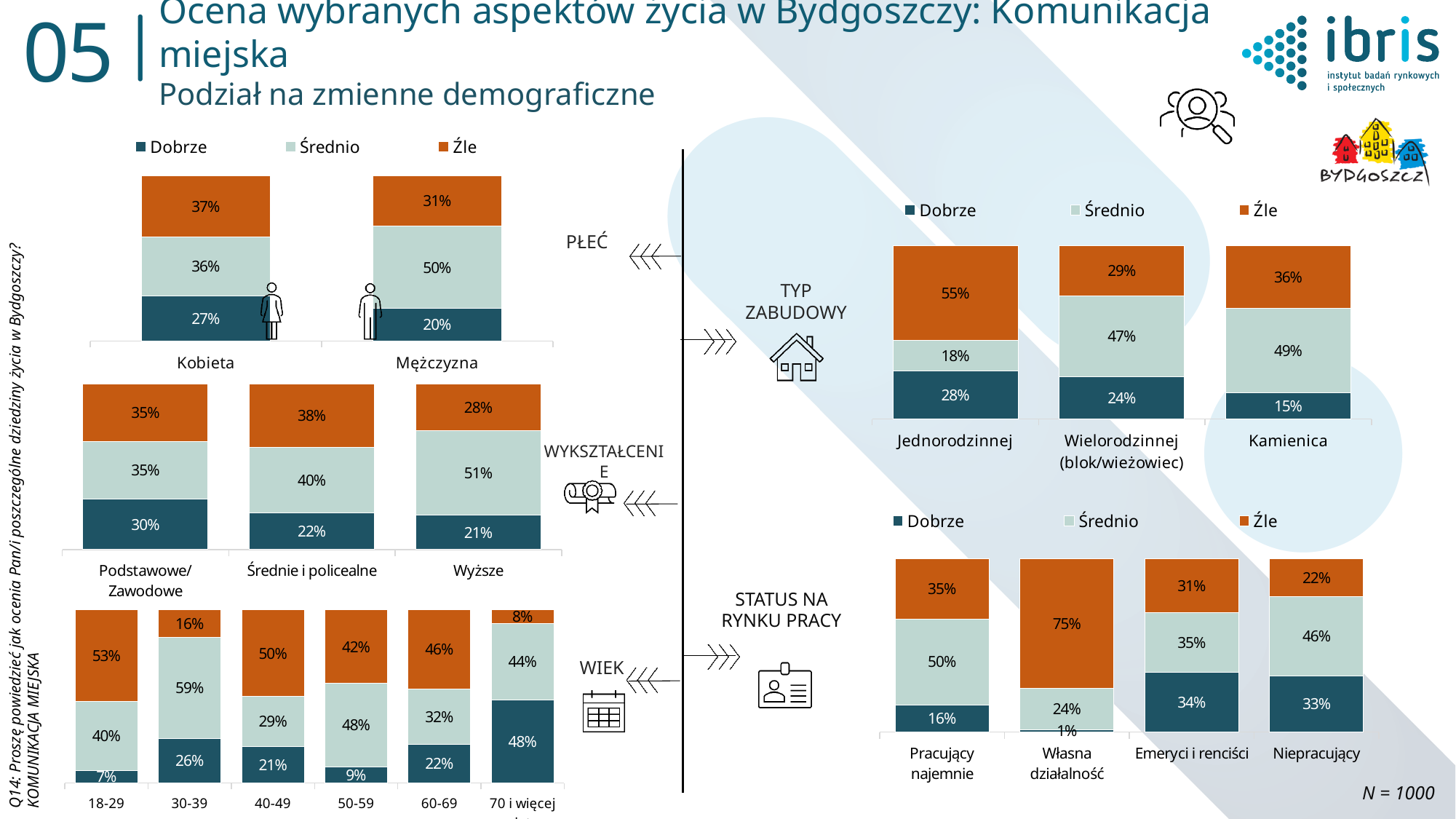
In the STATUS NA RYNKU PRACY chart, what is the difference between the 'Dobrze' values for Emeryci i renciści and Pracujący najemnie? 18 percentage points In the WYKSZTAŁCENIE (education) chart, which category has the highest 'Źle' share? Średnie i policealne How many series does the legend list for the charts on this slide? 3 In the TYP ZABUDOWY (building type) chart, what is the 'Źle' value for Jednorodzinnej? 55% In the PŁEĆ (gender) chart, what is the 'Średnio' value for Mężczyzna? 50% In the WIEK (age) chart, which age group has the lowest 'Dobrze' share? 18-29 In the WIEK (age) chart, how many age groups are shown? 6 In the WIEK (age) chart, which age group has the highest 'Dobrze' share? 70 i więcej In the STATUS NA RYNKU PRACY (labour market status) chart, what is the 'Źle' value for Własna działalność? 75% In the PŁEĆ (gender) chart, what percentage of women (Kobieta) rated public transport 'Dobrze'? 27% In the WYKSZTAŁCENIE (education) chart, what is the difference between the 'Średnio' values for Wyższe and Podstawowe/Zawodowe? 16 percentage points In the TYP ZABUDOWY (building type) chart, is the 'Dobrze' value for Jednorodzinnej larger or smaller than for Kamienica? larger